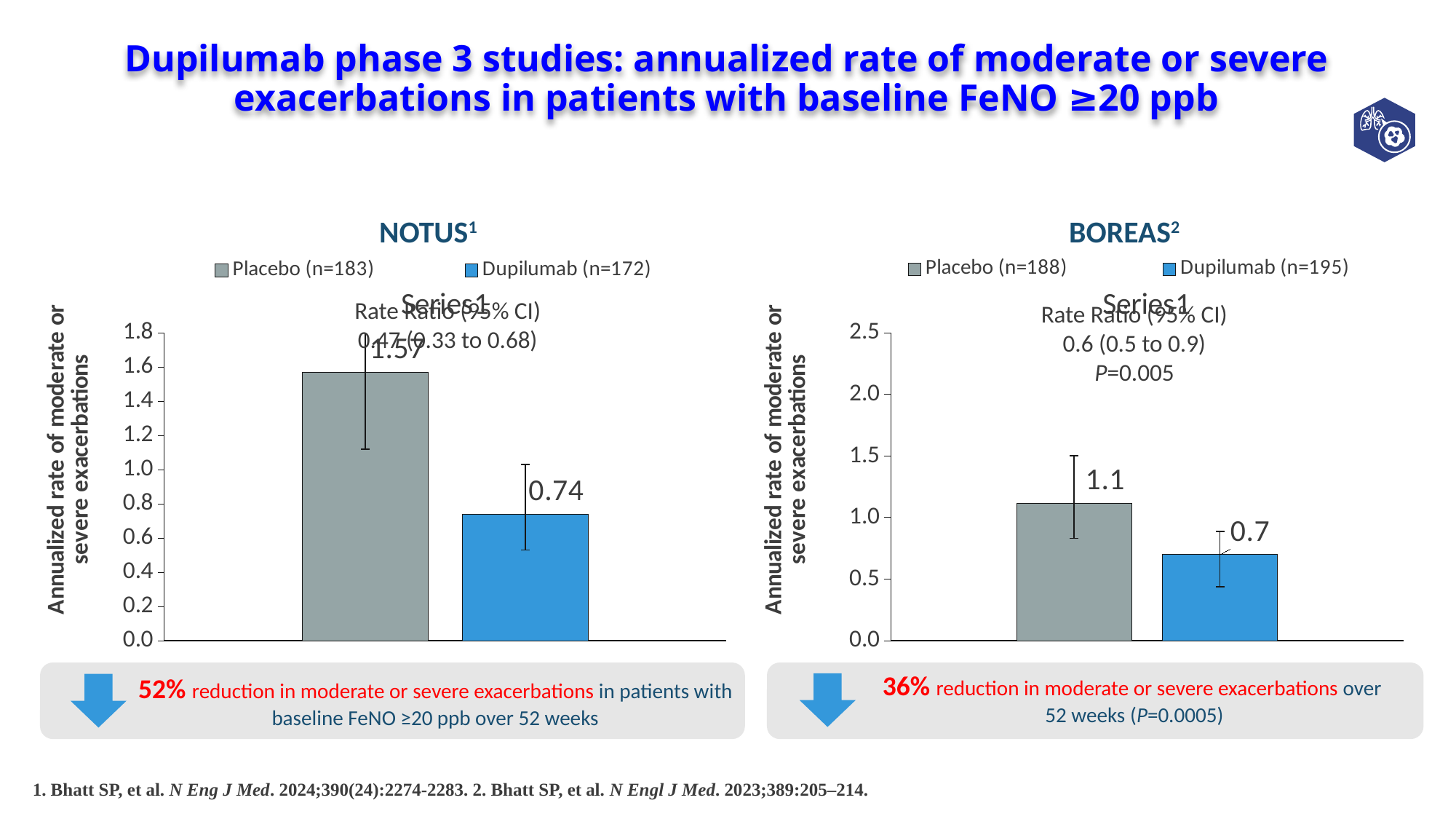
In the BOREAS chart, which group has the lower annualized exacerbation rate? Dupilumab In the NOTUS chart, which group has the higher annualized exacerbation rate? Placebo In the BOREAS chart, what is the annualized rate of moderate or severe exacerbations for Placebo? 1.1 In the BOREAS chart, what is the annualized rate of moderate or severe exacerbations for Dupilumab? 0.7 In the NOTUS chart, what is the difference between the Placebo and Dupilumab annualized exacerbation rates? 0.83 What type of chart is used for the NOTUS study? bar chart In the NOTUS chart, is the value for Dupilumab greater or less than 1.0? less In the NOTUS chart, what is the annualized rate of moderate or severe exacerbations for Dupilumab? 0.74 In the NOTUS chart, what is the annualized rate of moderate or severe exacerbations for Placebo? 1.57 In the BOREAS chart, how many patients were in the Dupilumab group according to the legend? 195 In the BOREAS chart, what is the difference between the Placebo and Dupilumab annualized exacerbation rates? 0.4 In the BOREAS chart, is the Placebo value larger or smaller than the Dupilumab value? larger